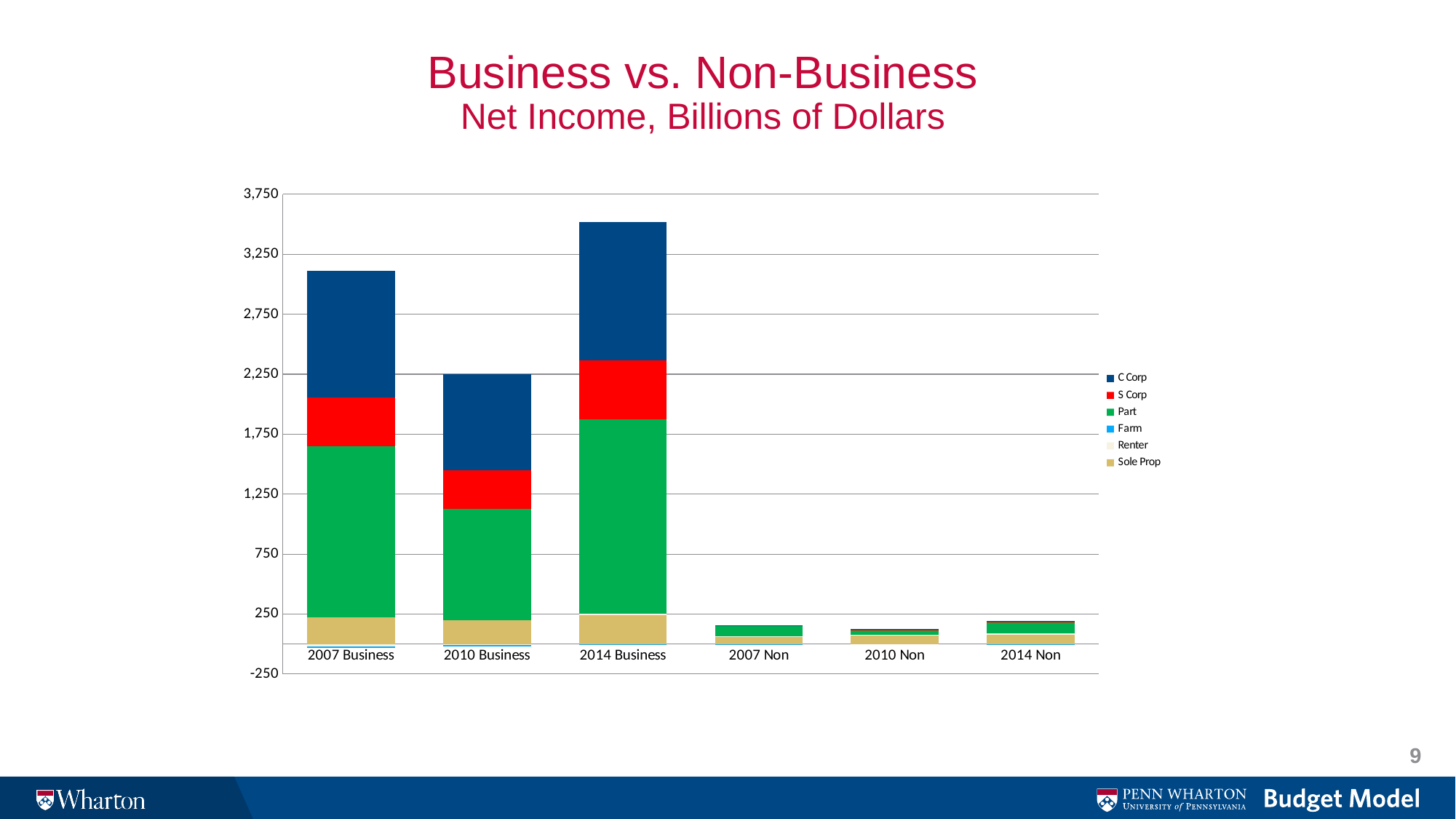
Is the total for 2007 Non greater or less than 250? less Is the total for 2007 Business greater or less than 3,250? less Which stacked bar is taller, 2014 Business or 2014 Non? 2014 Business Is the total for 2007 Business greater or less than 2,750? greater Which series is shown in dark blue in the legend? C Corp How many series does the legend list? 6 What kind of chart is shown on the slide? bar chart Which category has the tallest stacked bar? 2014 Business Which stacked bar is taller, 2007 Business or 2010 Business? 2007 Business What is the title of the chart on the slide? Business vs. Non-Business Net Income, Billions of Dollars How many categories are shown along the x axis? 6